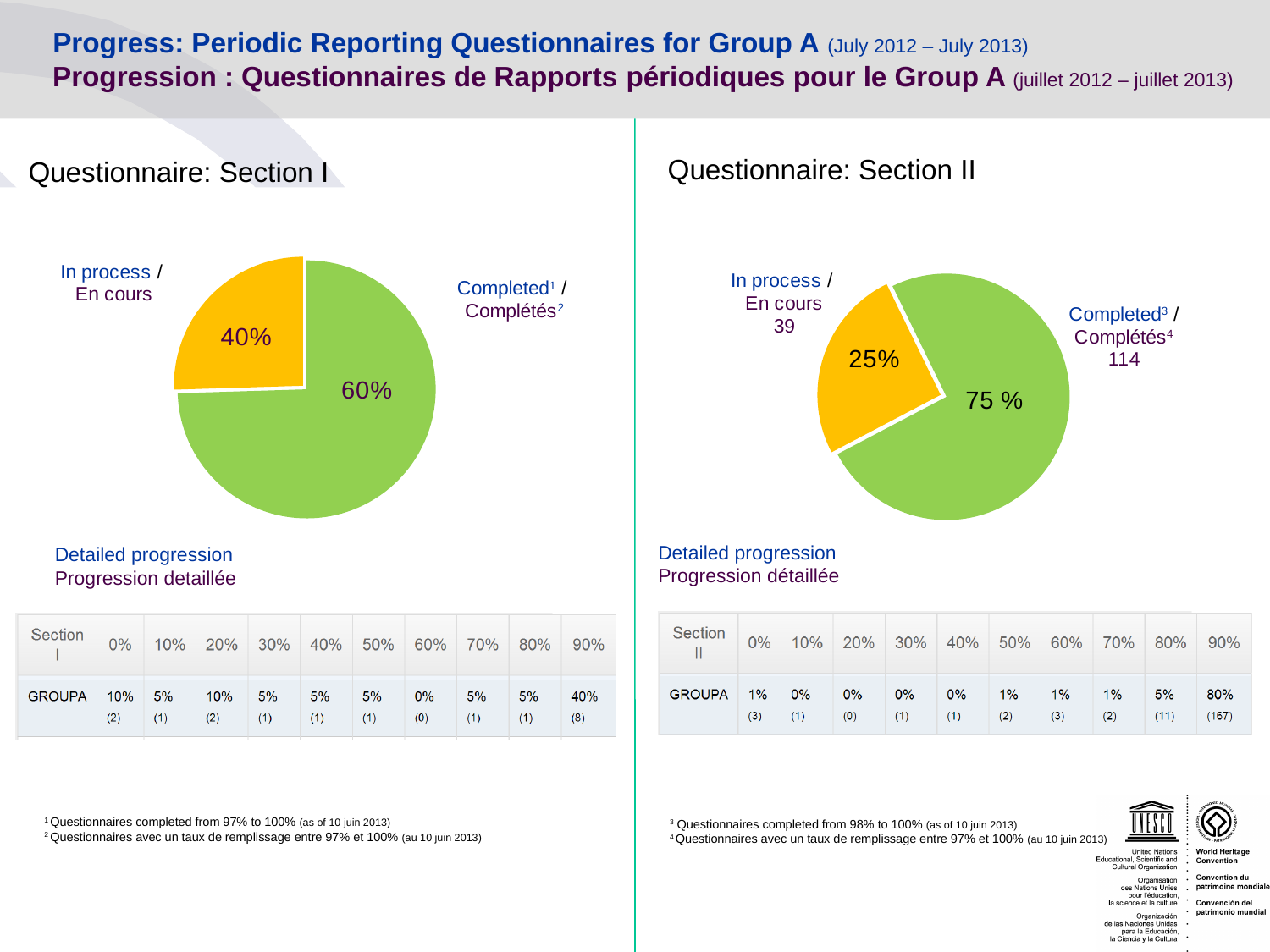
On the Questionnaire: Section II chart, which slice is the smallest? In process How many slices does the Questionnaire: Section II pie chart have? 2 On the Questionnaire: Section II chart, what share of questionnaires is Completed? 75 % On the Questionnaire: Section I chart, what share of questionnaires is In process? 40% On the Questionnaire: Section II chart, how many questionnaires are Completed? 114 On the Questionnaire: Section I chart, what is the difference in percentage points between the Completed and In process slices? 20 On the Questionnaire: Section II chart, what share of questionnaires is In process? 25% What kind of chart is used for Questionnaire: Section I? Pie chart On the Questionnaire: Section I chart, what share of questionnaires is Completed? 60% On the Questionnaire: Section I chart, which slice is the largest? Completed On the Questionnaire: Section II chart, how many questionnaires are In process? 39 On the Questionnaire: Section II chart, what is the difference between the number of Completed and In process questionnaires? 75